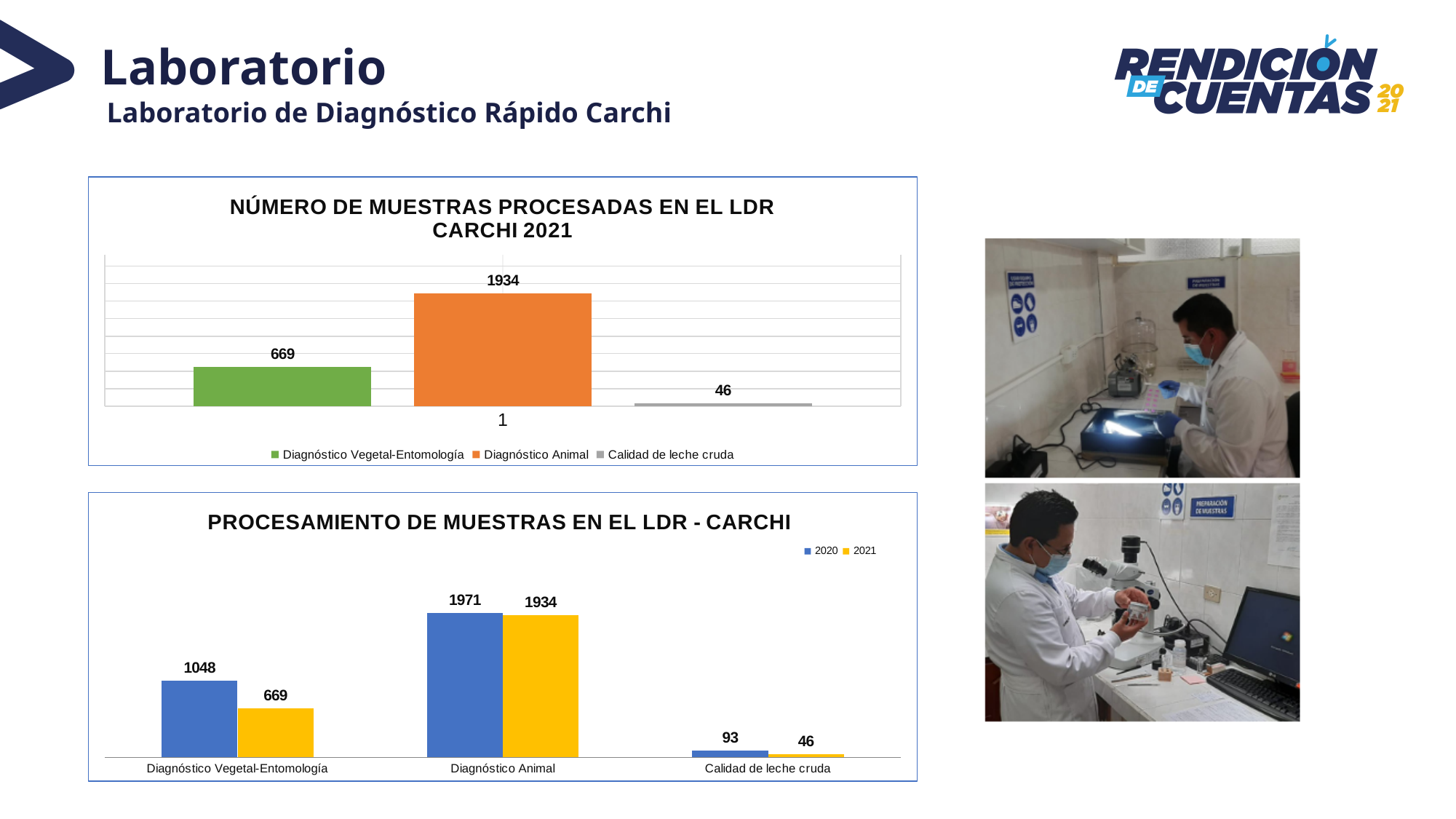
In the chart 'NÚMERO DE MUESTRAS PROCESADAS EN EL LDR CARCHI 2021', what is the value for Diagnóstico Animal? 1934 In the chart 'PROCESAMIENTO DE MUESTRAS EN EL LDR - CARCHI', what is the 2021 value for Calidad de leche cruda? 46 In the chart 'PROCESAMIENTO DE MUESTRAS EN EL LDR - CARCHI', which category has the highest 2020 value? Diagnóstico Animal In the chart 'PROCESAMIENTO DE MUESTRAS EN EL LDR - CARCHI', what is the difference between the 2020 and 2021 values for Diagnóstico Vegetal-Entomología? 379 In the chart 'NÚMERO DE MUESTRAS PROCESADAS EN EL LDR CARCHI 2021', which series has the lowest value? Calidad de leche cruda What kind of chart is 'NÚMERO DE MUESTRAS PROCESADAS EN EL LDR CARCHI 2021'? Bar chart In the chart 'PROCESAMIENTO DE MUESTRAS EN EL LDR - CARCHI', which is larger for Calidad de leche cruda, the 2020 value or the 2021 value? 2020 How many categories are shown on the x axis of the chart 'PROCESAMIENTO DE MUESTRAS EN EL LDR - CARCHI'? 3 In the chart 'PROCESAMIENTO DE MUESTRAS EN EL LDR - CARCHI', which colour represents the 2021 series? Yellow How many series does the legend of the chart 'NÚMERO DE MUESTRAS PROCESADAS EN EL LDR CARCHI 2021' list? 3 In the chart 'PROCESAMIENTO DE MUESTRAS EN EL LDR - CARCHI', what is the 2020 value for Diagnóstico Vegetal-Entomología? 1048 In the chart 'NÚMERO DE MUESTRAS PROCESADAS EN EL LDR CARCHI 2021', what is the difference between Diagnóstico Animal and Diagnóstico Vegetal-Entomología? 1265